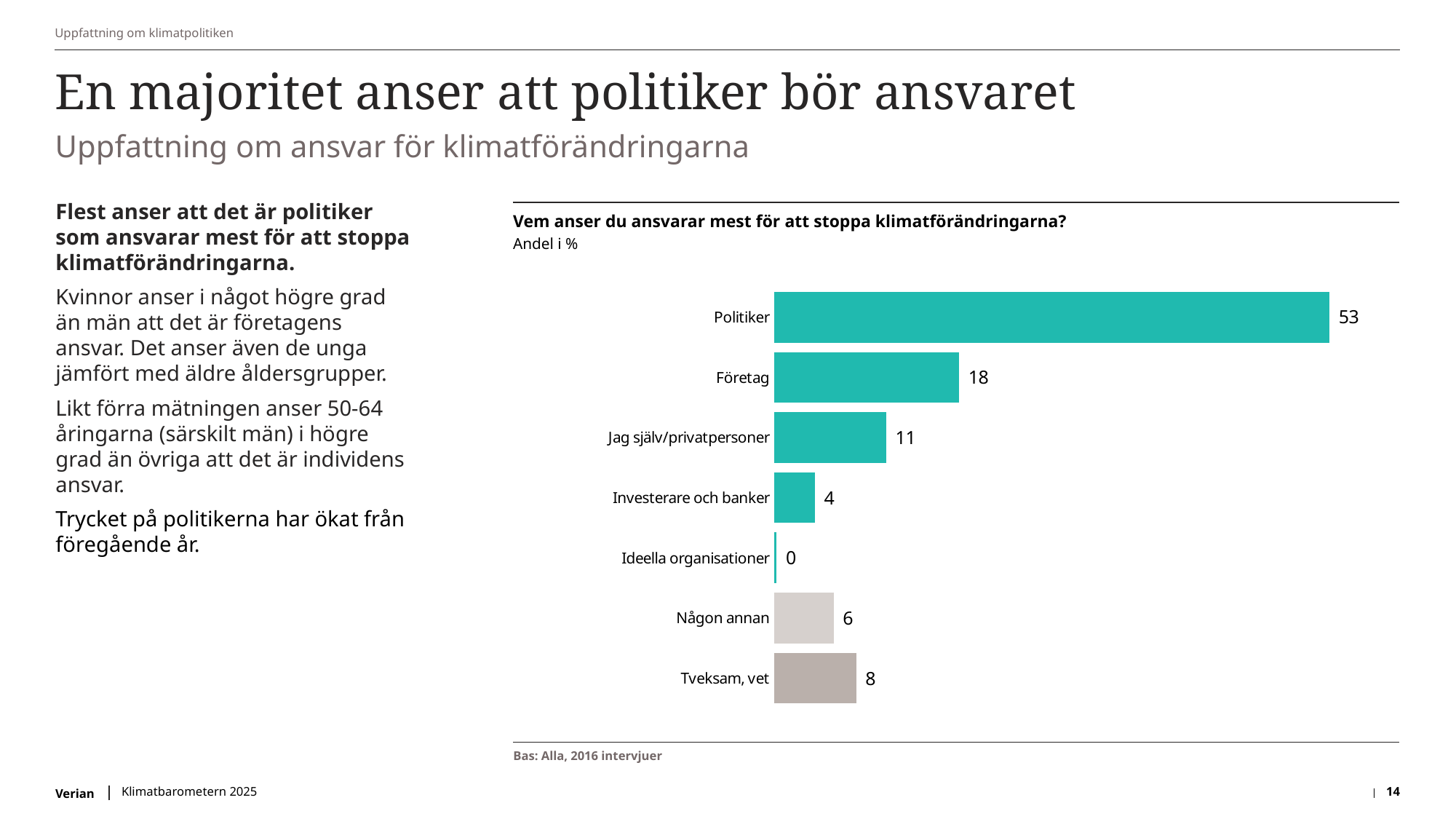
Which category has the highest value? Politiker What is the value for Investerare och banker? 4 How many categories are shown in the chart? 7 What is the difference between the values for Politiker and Företag? 35 Which is larger, the value for Tveksam, vet or the value for Någon annan? Tveksam, vet What is the value for Företag? 18 What is the value for Tveksam, vet? 8 What is the value for Ideella organisationer? 0 What is the value for Politiker? 53 What is the value for Jag själv/privatpersoner? 11 What kind of chart is shown on the slide? Bar chart Which category has the lowest value? Ideella organisationer